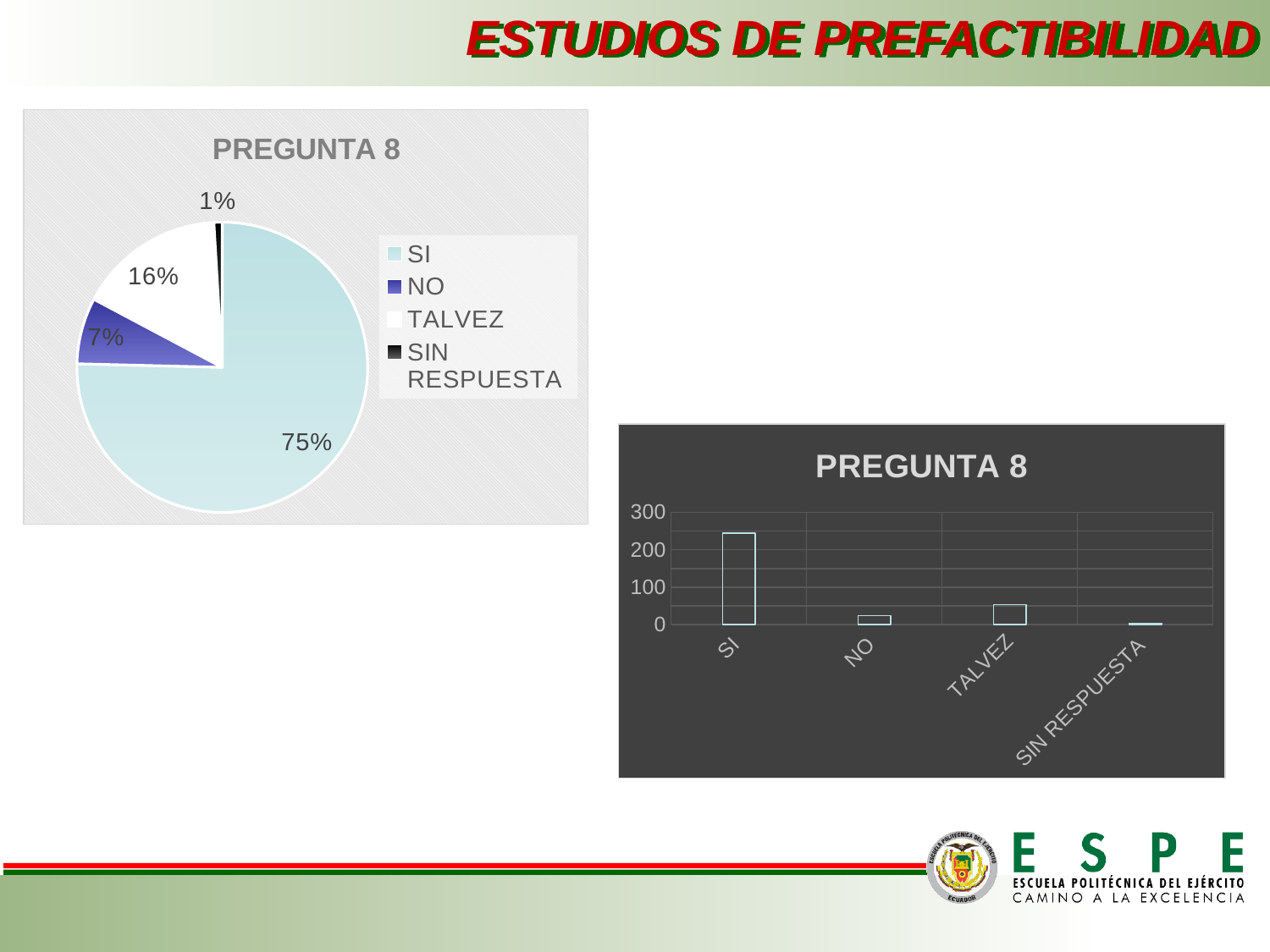
In the pie chart on the left, what share does NO have? 7% How many categories are shown on the x axis of the bar chart on the right? 4 In the pie chart on the left, which category has the smallest slice? SIN RESPUESTA In the pie chart on the left, which category has the largest slice? SI In the pie chart on the left, what is the difference in percentage points between TALVEZ and NO? 9 In the bar chart on the right, is the value for SI greater or less than 200? greater In the pie chart on the left, what share does TALVEZ have? 16% What type of chart is the one on the right of the slide? bar chart In the pie chart on the left, what share does SI have? 75% In the bar chart on the right, is the value for TALVEZ greater or less than 100? less What type of chart is the one on the left of the slide? pie chart